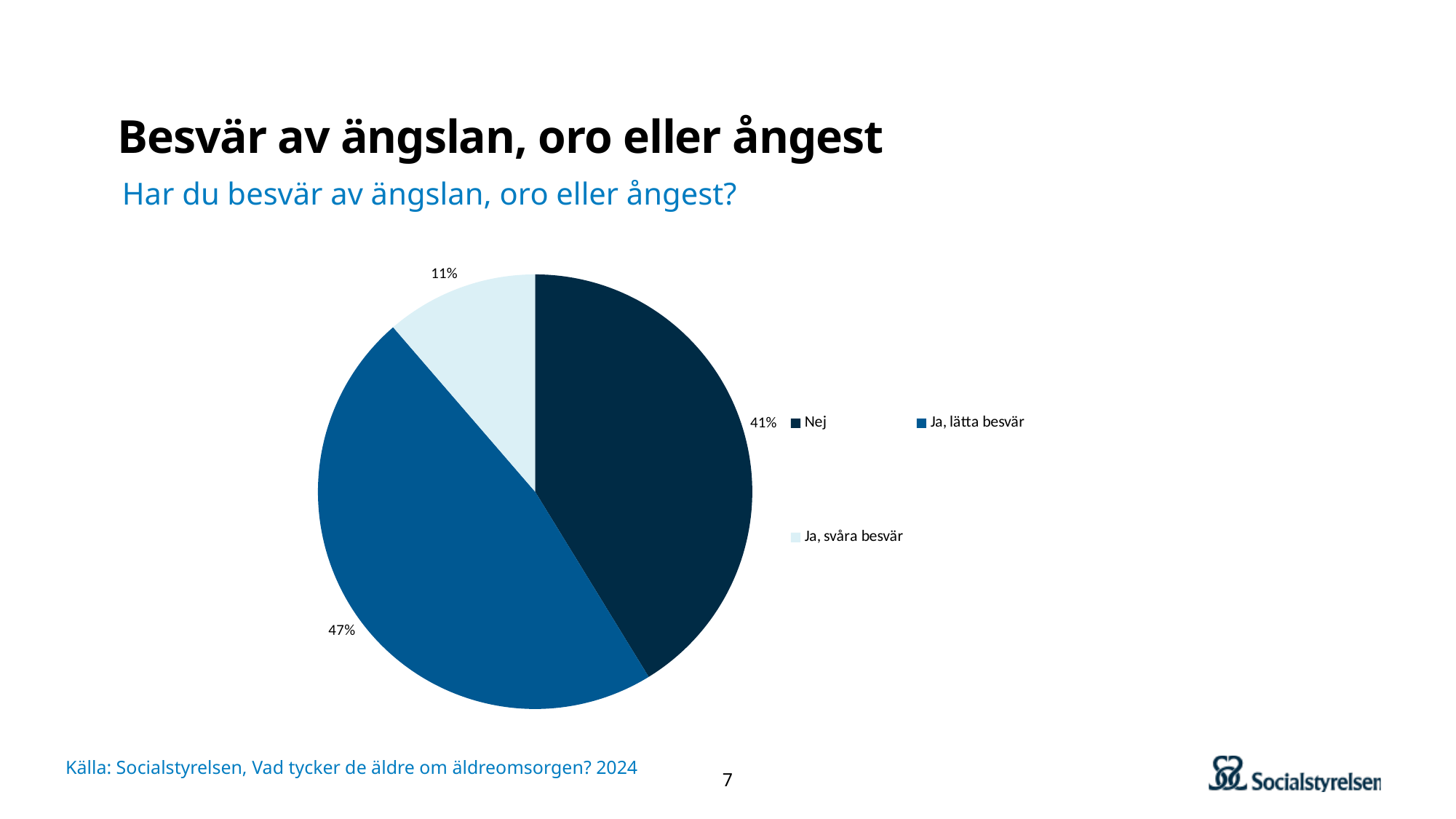
Which category has the largest slice of the pie? Ja, lätta besvär What kind of chart is shown on the slide? Pie chart How many categories does the pie chart show? 3 What is the difference between the shares for "Nej" and "Ja, svåra besvär"? 30 percentage points Which is larger, the share for "Nej" or the share for "Ja, svåra besvär"? Nej What share of the pie is labelled "Ja, lätta besvär"? 47% What is the difference between the shares for "Ja, lätta besvär" and "Nej"? 6 percentage points What share of the pie is labelled "Ja, svåra besvär"? 11% How many entries does the legend list? 3 What share of the pie is labelled "Nej"? 41% Which category has the smallest slice of the pie? Ja, svåra besvär What question is shown as the chart's subtitle? Har du besvär av ängslan, oro eller ångest?